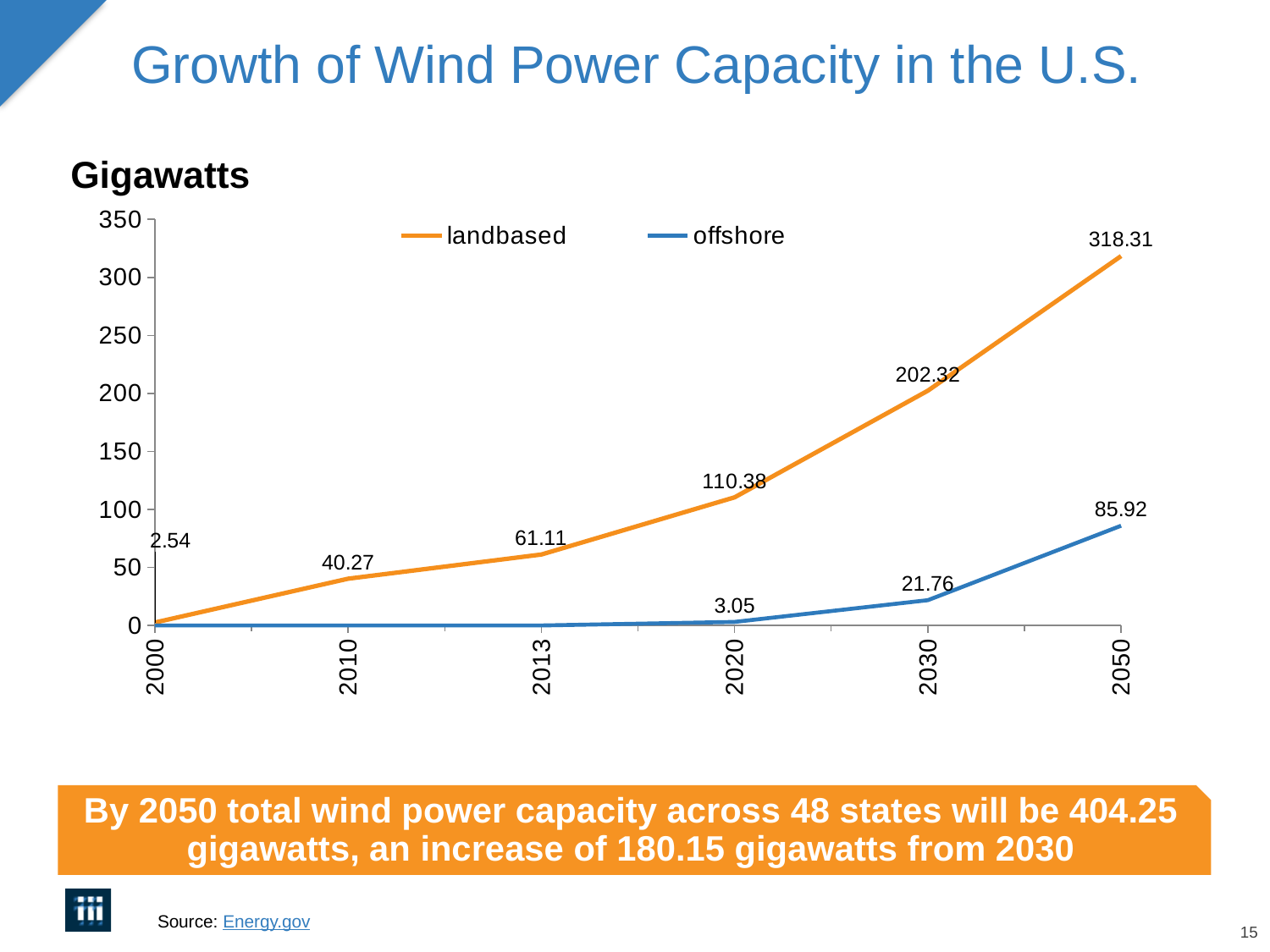
In which year is the landbased capacity lowest? 2000 Is the offshore value for 2013 greater or less than 50? less How many series does the legend list? 2 In which year is the landbased capacity highest? 2050 How many years are shown on the x axis? 6 What is the landbased wind power capacity in 2020? 110.38 By how much does offshore capacity increase from 2030 to 2050? 64.16 What is the offshore wind power capacity in 2030? 21.76 What kind of chart is shown on the slide? line chart What is the landbased wind power capacity in 2050? 318.31 In 2050, which series has the larger value, landbased or offshore? landbased By how much does landbased capacity increase from 2030 to 2050? 115.99